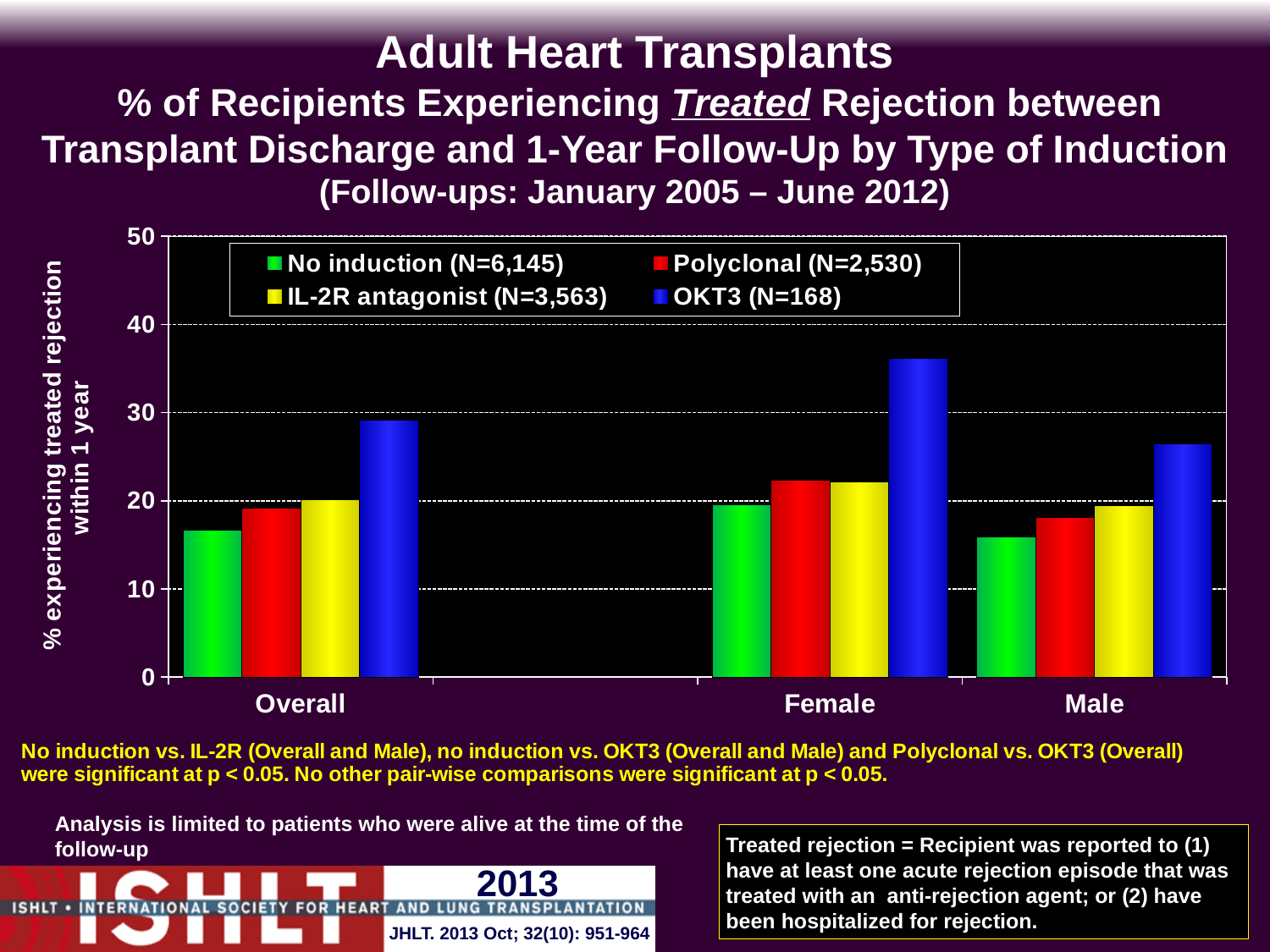
What kind of chart is shown on the slide? bar chart Which is larger: the OKT3 value for Female or the OKT3 value for Male? Female Is the value for OKT3 in the Male category greater or less than 20? greater Which induction type has the highest value in the Female category? OKT3 Which induction type has the lowest value in the Overall category? No induction Which induction type has the highest value in the Male category? OKT3 Is the value for No induction in the Overall category greater or less than 20? less According to the legend, what is the N for the OKT3 group? 168 How many series does the legend list? 4 How many categories are shown on the x axis? 3 Is the value for OKT3 in the Female category greater or less than 30? greater